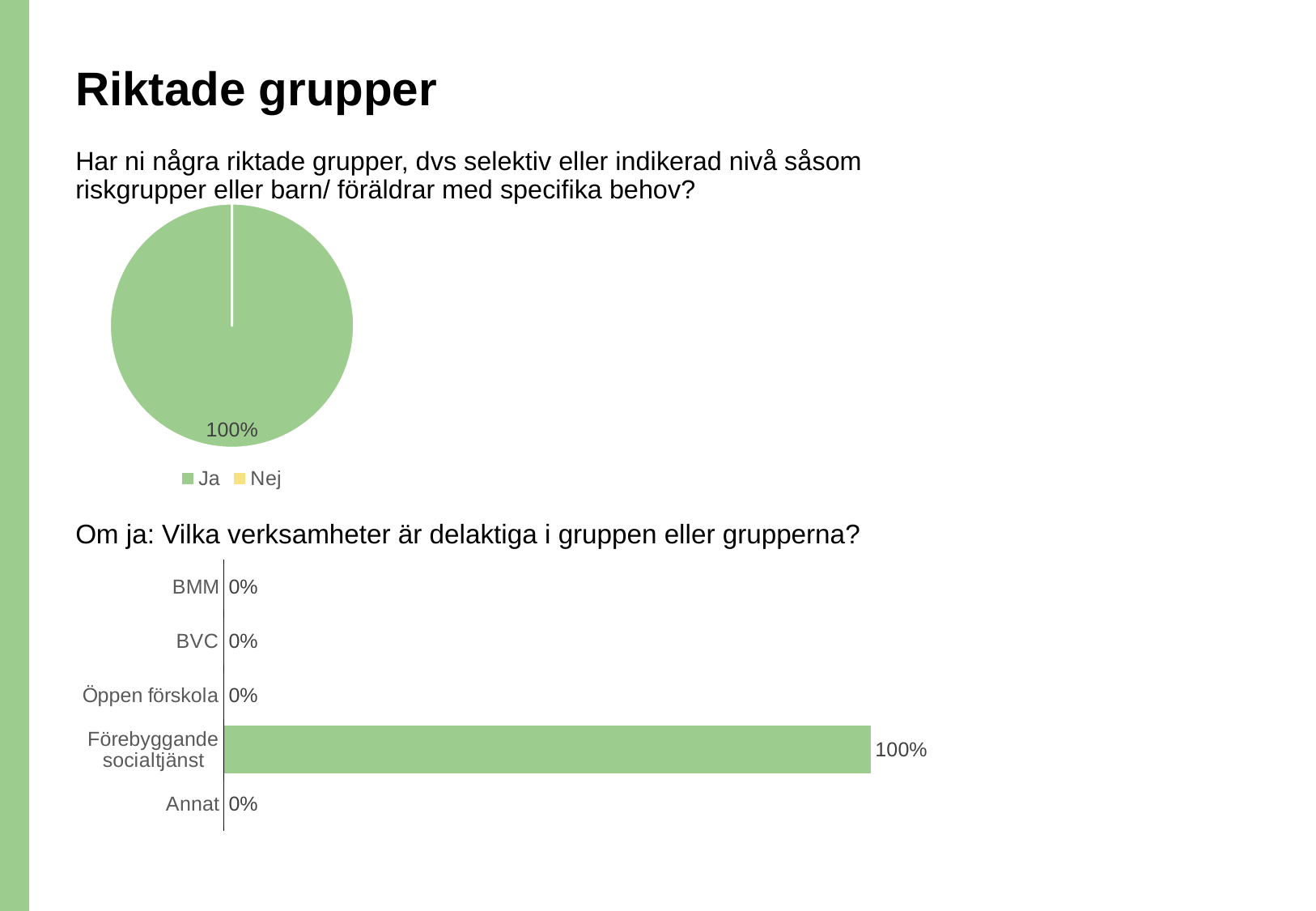
What kind of chart is the bottom chart on the slide (under 'Om ja: Vilka verksamheter är delaktiga i gruppen eller grupperna?')? bar chart In the bottom bar chart, what is the value for 'Förebyggande socialtjänst'? 100% In the pie chart at the top of the slide, what share of the pie does the 'Ja' slice take? 100% In the bottom bar chart, what is the value for 'Öppen förskola'? 0% How many entries does the legend of the pie chart at the top of the slide list? 2 In the bottom bar chart, what is the difference between the values for 'Förebyggande socialtjänst' and 'Annat'? 100% In the bottom bar chart, which is larger: the value for 'BMM' or the value for 'Förebyggande socialtjänst'? Förebyggande socialtjänst In the bottom bar chart, what is the value for 'BVC'? 0% How many categories are shown in the bottom bar chart? 5 What are the two legend entries of the pie chart at the top of the slide? Ja and Nej In the bottom bar chart, which category has the highest value? Förebyggande socialtjänst What kind of chart is the top chart on the slide? pie chart